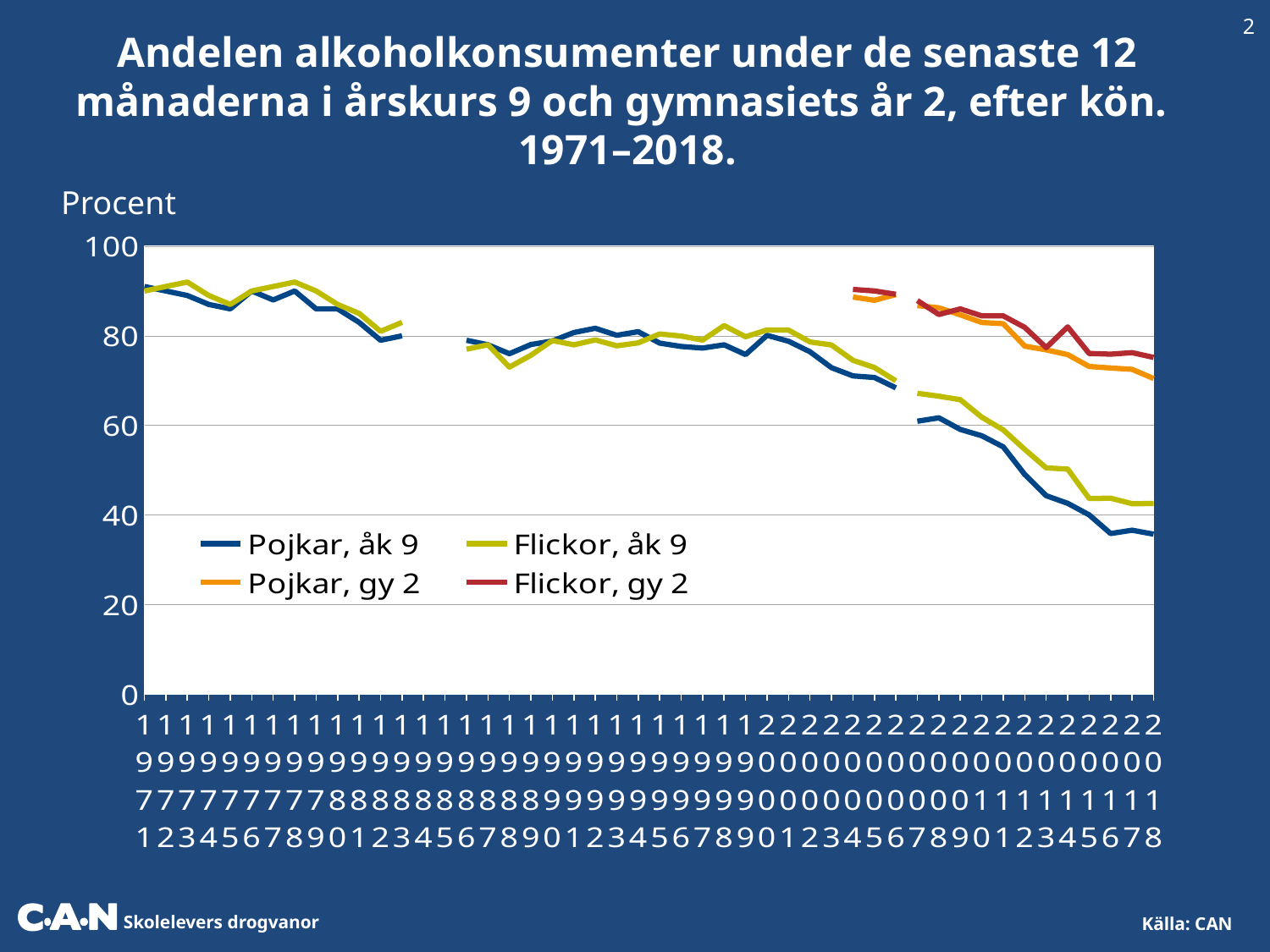
Is the value for Pojkar, åk 9 in 1971 greater or less than 80? greater Is the value for Pojkar, åk 9 in 2018 greater or less than 40? less How many series does the legend list? 4 Does the value for Pojkar, åk 9 rise or fall from 1971 to 2018? fall Which series is drawn in orange? Pojkar, gy 2 Which series has the highest value in 2018? Flickor, gy 2 Is the value for Pojkar, gy 2 in 2018 greater or less than 60? greater What is the label on the vertical axis? Procent How many years are shown on the x axis? 48 Which series has the lowest value in 2018? Pojkar, åk 9 What kind of chart is shown on the slide? line chart